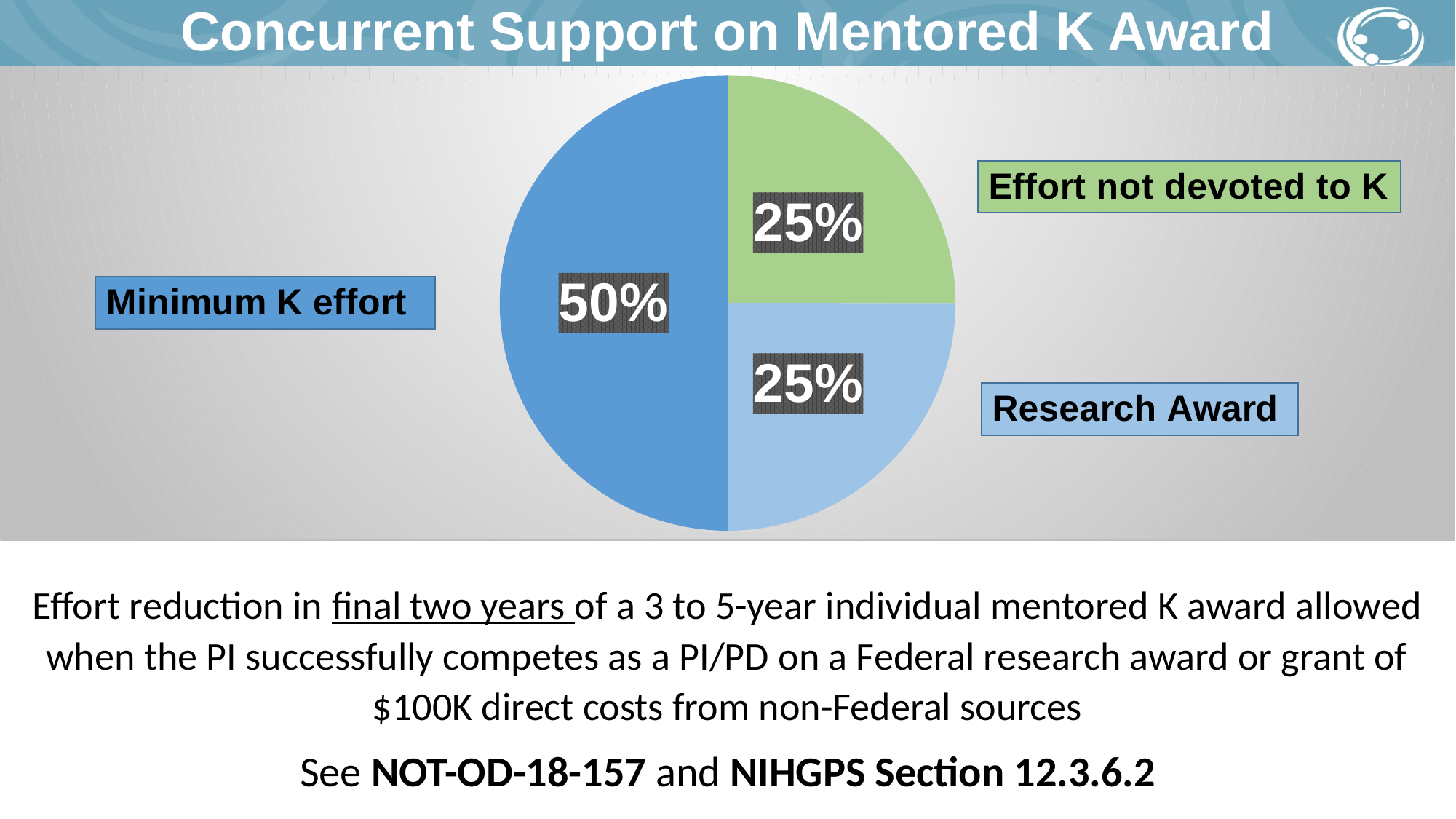
What is the difference between the Minimum K effort slice and the Research Award slice? 25% What share of the pie is labelled Research Award? 25% What share of the pie is labelled Minimum K effort? 50% What is the combined share of the Research Award and Effort not devoted to K slices? 50% What share of the pie is labelled Effort not devoted to K? 25% How many slices does the pie chart have? 3 Which slice of the pie is the largest? Minimum K effort What is the title of the slide containing the pie chart? Concurrent Support on Mentored K Award What colour is the Effort not devoted to K slice? green Which is larger, the Minimum K effort slice or the Effort not devoted to K slice? Minimum K effort What kind of chart is shown on the slide? pie chart